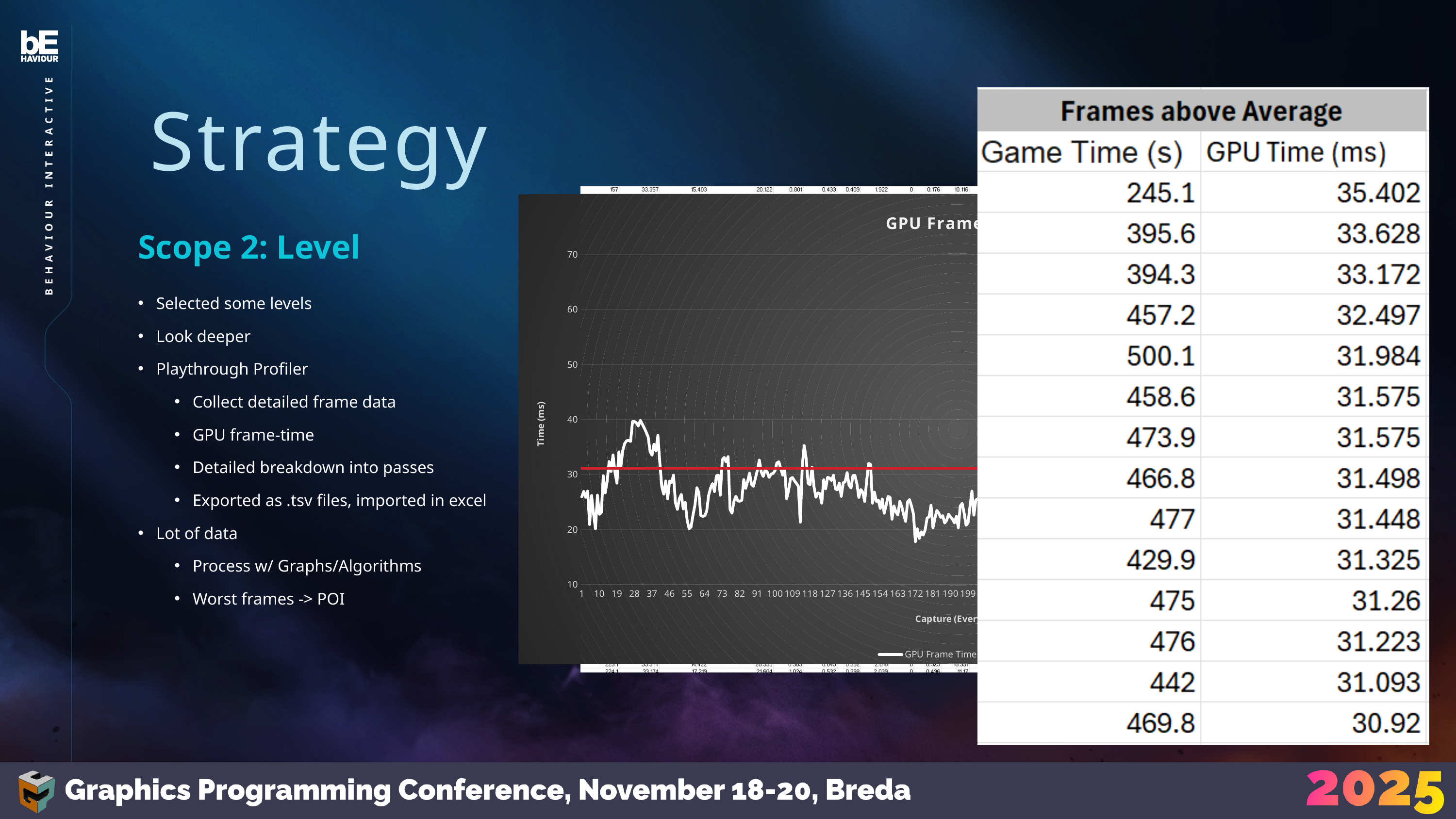
What is the label on the y-axis of the line chart? Time (ms) Does the white line rise or fall between capture 1 and capture 28? rise What is the highest tick value shown on the y-axis of the line chart? 70 Is the value of the white line at capture 1 greater or less than 30? less Is the red horizontal line in the line chart greater or less than 20? greater Is the peak value of the white line in the line chart greater or less than 30? greater What kind of chart is shown in the middle of the slide? line chart What is the first tick label on the x-axis of the line chart? 1 Does the white line rise or fall between capture 37 and capture 46? fall